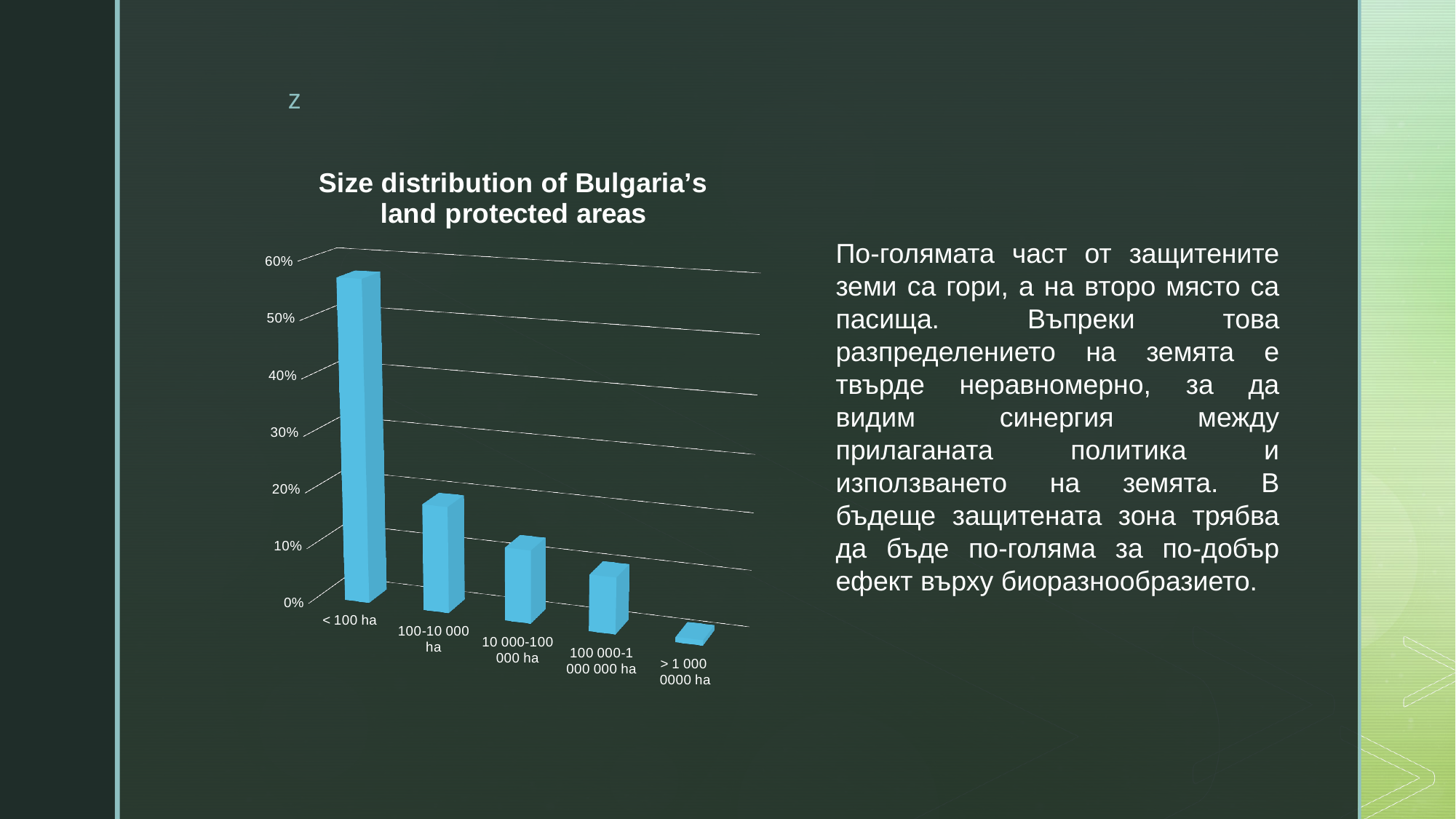
Which size category has the lowest share of Bulgaria's land protected areas? > 1 000 0000 ha Is the value for 10 000-100 000 ha greater or less than 20%? less Is the value for < 100 ha greater or less than 50%? greater What kind of chart is shown on the slide? bar chart How many size categories are shown on the x axis of the chart? 5 What colour are the bars in the chart? blue What is the title of the chart? Size distribution of Bulgaria's land protected areas Do the values rise or fall as the size categories increase along the x axis? fall Which size category has the highest share of Bulgaria's land protected areas? < 100 ha Is the value for 100-10 000 ha greater or less than 30%? less Which has a larger share: < 100 ha or 100-10 000 ha? < 100 ha